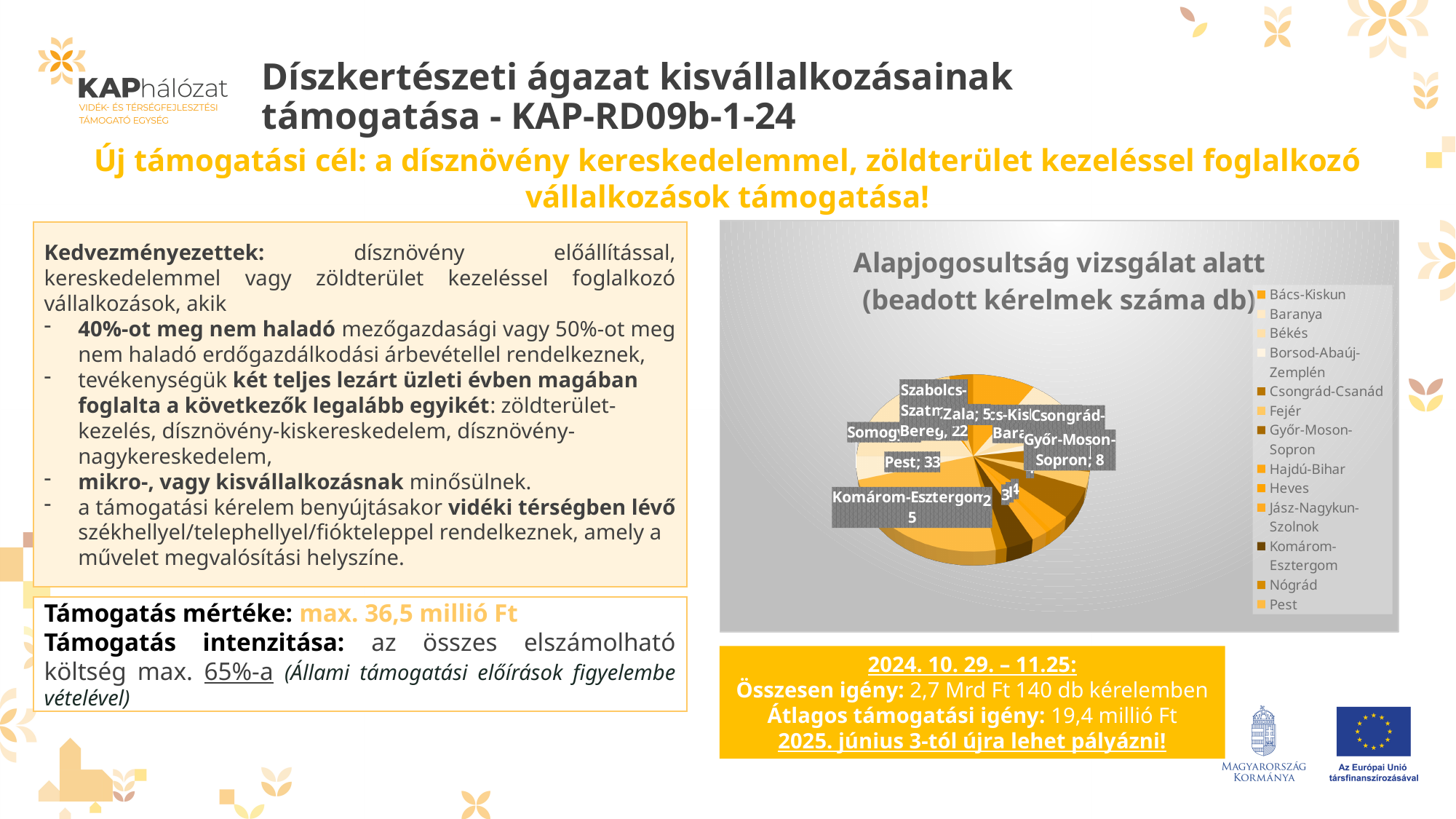
How many submitted applications does the chart show for Pest? 33 What is the difference between the number of applications for Pest and for Szabolcs-Szatmár-Bereg? 11 Which has more submitted applications, Győr-Moson-Sopron or Komárom-Esztergom? Győr-Moson-Sopron How many submitted applications does the chart show for Zala? 5 Which has more submitted applications, Pest or Szabolcs-Szatmár-Bereg? Pest What is the title of the chart? Alapjogosultság vizsgálat alatt (beadott kérelmek száma db) Which county has the largest slice in the pie chart? Pest What kind of chart is shown on the slide? pie chart How many submitted applications does the chart show for Szabolcs-Szatmár-Bereg? 22 What is the difference between the number of applications for Szabolcs-Szatmár-Bereg and for Győr-Moson-Sopron? 14 How many submitted applications does the chart show for Győr-Moson-Sopron? 8 How many submitted applications does the chart show for Komárom-Esztergom? 5